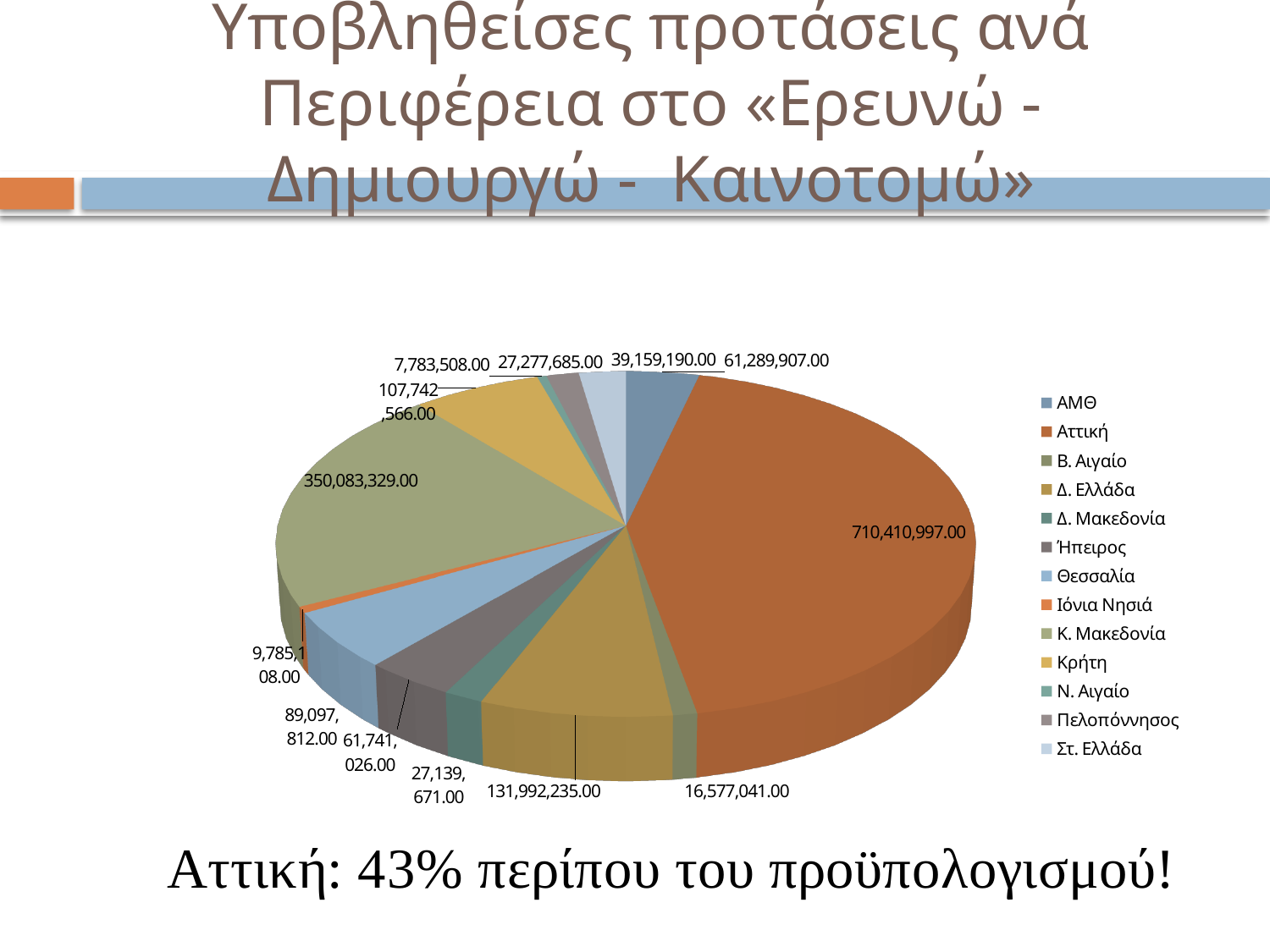
Which region has the largest slice of the pie chart? Αττική How many regions are shown in the pie chart? 13 Which region has the smallest value on the pie chart? Ν. Αιγαίο What is the value shown for Δ. Ελλάδα on the pie chart? 131,992,235.00 What is the value shown for Αττική on the pie chart? 710,410,997.00 What is the value shown for Κρήτη on the pie chart? 107,742,566.00 According to the text below the chart, approximately what share of the budget does Αττική represent? 43% Which region is listed first in the chart legend? ΑΜΘ What is the difference between the values for Αττική and Κ. Μακεδονία? 360,327,668.00 Which has a larger value, Θεσσαλία or Κρήτη? Κρήτη What is the value shown for Κ. Μακεδονία on the pie chart? 350,083,329.00 What type of chart is shown on the slide? Pie chart